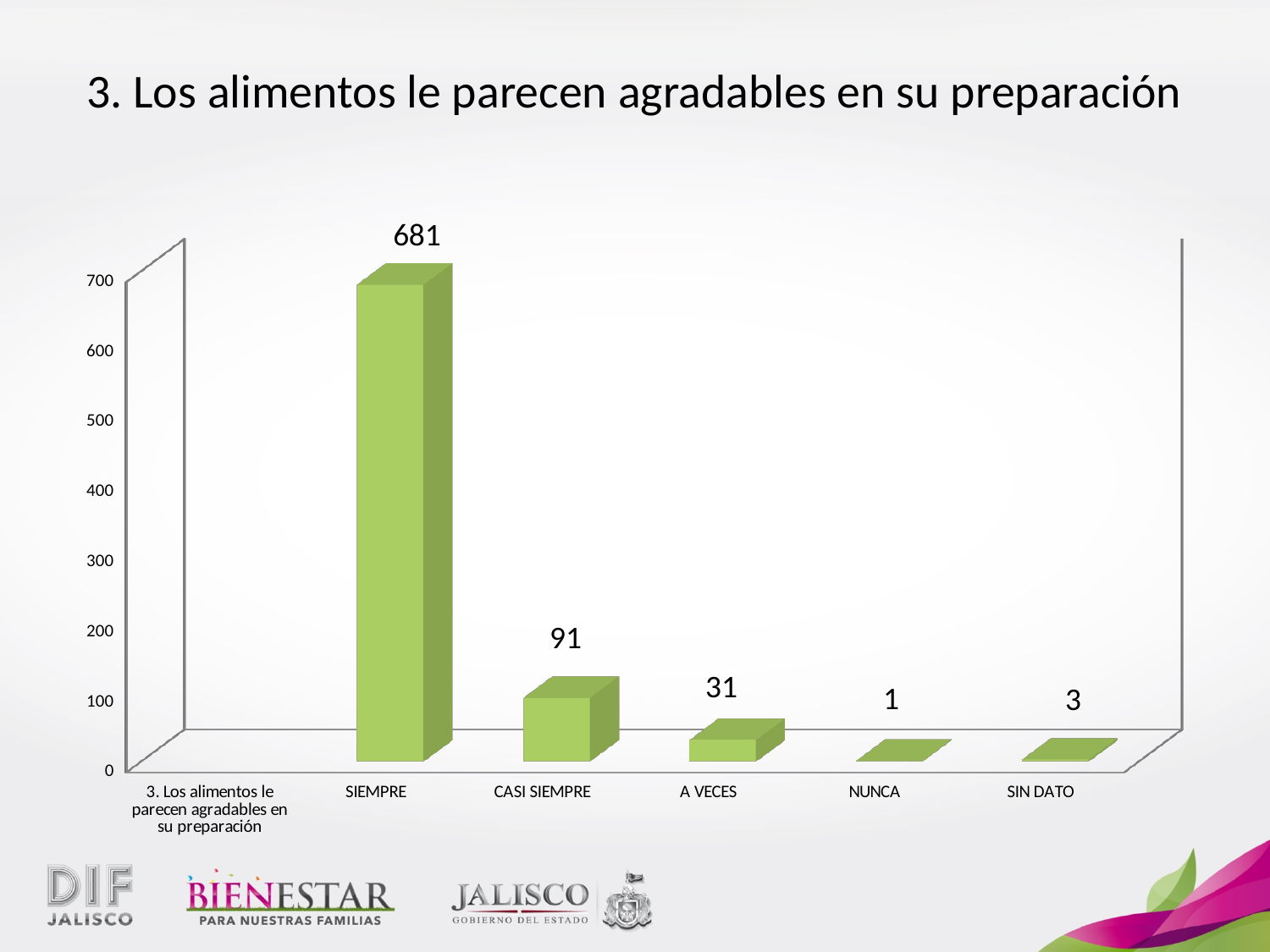
Which category has the highest value? SIEMPRE Which category has the lowest value? NUNCA What is the value for SIEMPRE? 681 What is the difference between the values for SIEMPRE and CASI SIEMPRE? 590 What kind of chart is shown on the slide? Bar chart Which is larger, the value for A VECES or the value for SIN DATO? A VECES How many bars are plotted in the chart? 5 What is the value for A VECES? 31 What is the value for CASI SIEMPRE? 91 What is the value for NUNCA? 1 What is the value for SIN DATO? 3 What is the title of the slide? 3. Los alimentos le parecen agradables en su preparación